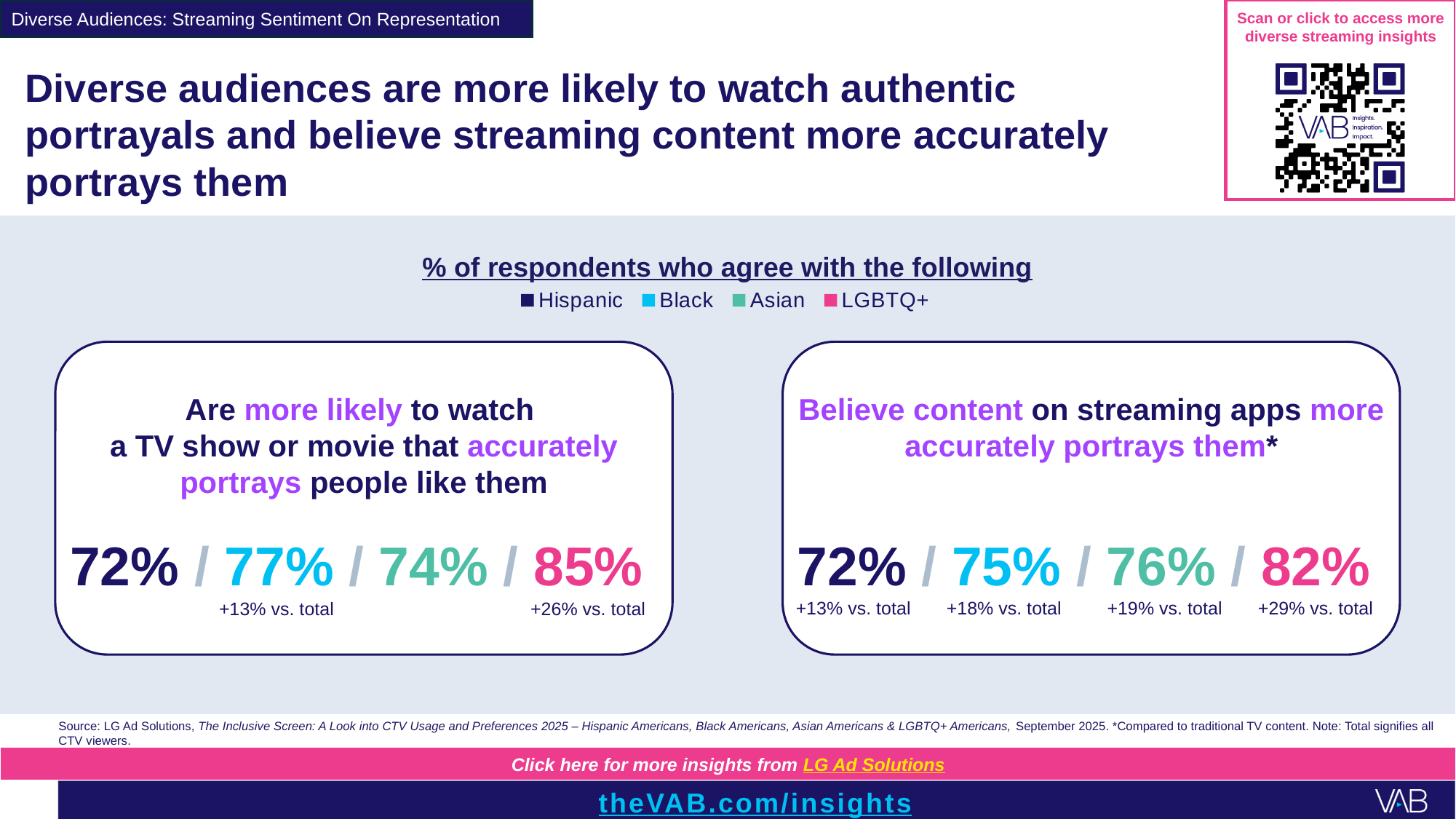
In the right panel ('Believe content on streaming apps more accurately portrays them'), what is the difference in percentage points between LGBTQ+ and Black respondents? 7 percentage points In the left panel ('Are more likely to watch a TV show or movie that accurately portrays people like them'), which audience group has the highest percentage? LGBTQ+ In the left panel ('Are more likely to watch a TV show or movie that accurately portrays people like them'), what percentage of Hispanic respondents agree? 72% In the left panel ('Are more likely to watch a TV show or movie that accurately portrays people like them'), what is the difference in percentage points between LGBTQ+ and Hispanic respondents? 13 percentage points In the right panel ('Believe content on streaming apps more accurately portrays them'), which audience group has the lowest percentage? Hispanic In the left panel ('Are more likely to watch a TV show or movie that accurately portrays people like them'), what percentage of LGBTQ+ respondents agree? 85% In the right panel ('Believe content on streaming apps more accurately portrays them'), what percentage of Black respondents agree? 75% How many audience groups does the legend list? 4 Which colour represents Asian respondents in the legend? Teal/green In the right panel ('Believe content on streaming apps more accurately portrays them'), how many percentage points above the total is the LGBTQ+ value? +29% vs. total In the left panel ('Are more likely to watch a TV show or movie that accurately portrays people like them'), which is larger: the value for Black or the value for Asian respondents? Black In the right panel ('Believe content on streaming apps more accurately portrays them'), what percentage of Asian respondents agree? 76%